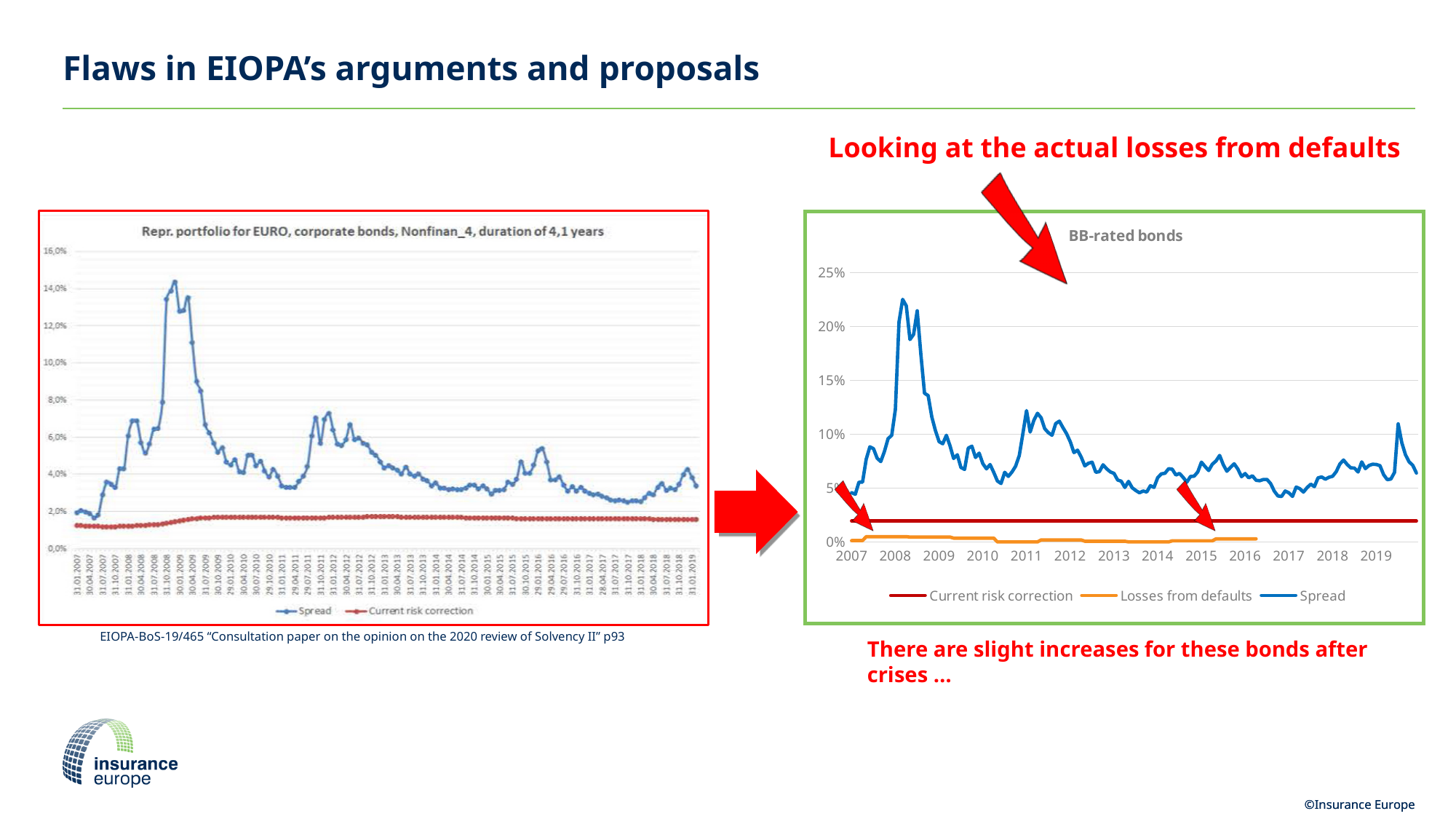
In the 'BB-rated bonds' chart, which series has the highest values across the whole period? Spread In the 'BB-rated bonds' chart, which series has the lowest values? Losses from defaults How many series does the legend of the left chart ('Repr. portfolio for EURO, corporate bonds, Nonfinan_4, duration of 4,1 years') list? 2 What kind of chart is the 'BB-rated bonds' chart on the right? line chart In the 'BB-rated bonds' chart, is the Spread value in 2017 greater or less than 10%? less How many series does the legend of the 'BB-rated bonds' chart list? 3 In the 'BB-rated bonds' chart, is the peak value of the Spread series greater or less than 20%? greater In the 'BB-rated bonds' chart, which series is drawn in orange? Losses from defaults In the 'BB-rated bonds' chart, in which year does the Spread series reach its highest value? 2008 In the left chart ('Repr. portfolio for EURO, corporate bonds, Nonfinan_4, duration of 4,1 years'), is the Current risk correction series greater or less than 2,0% throughout the period? less